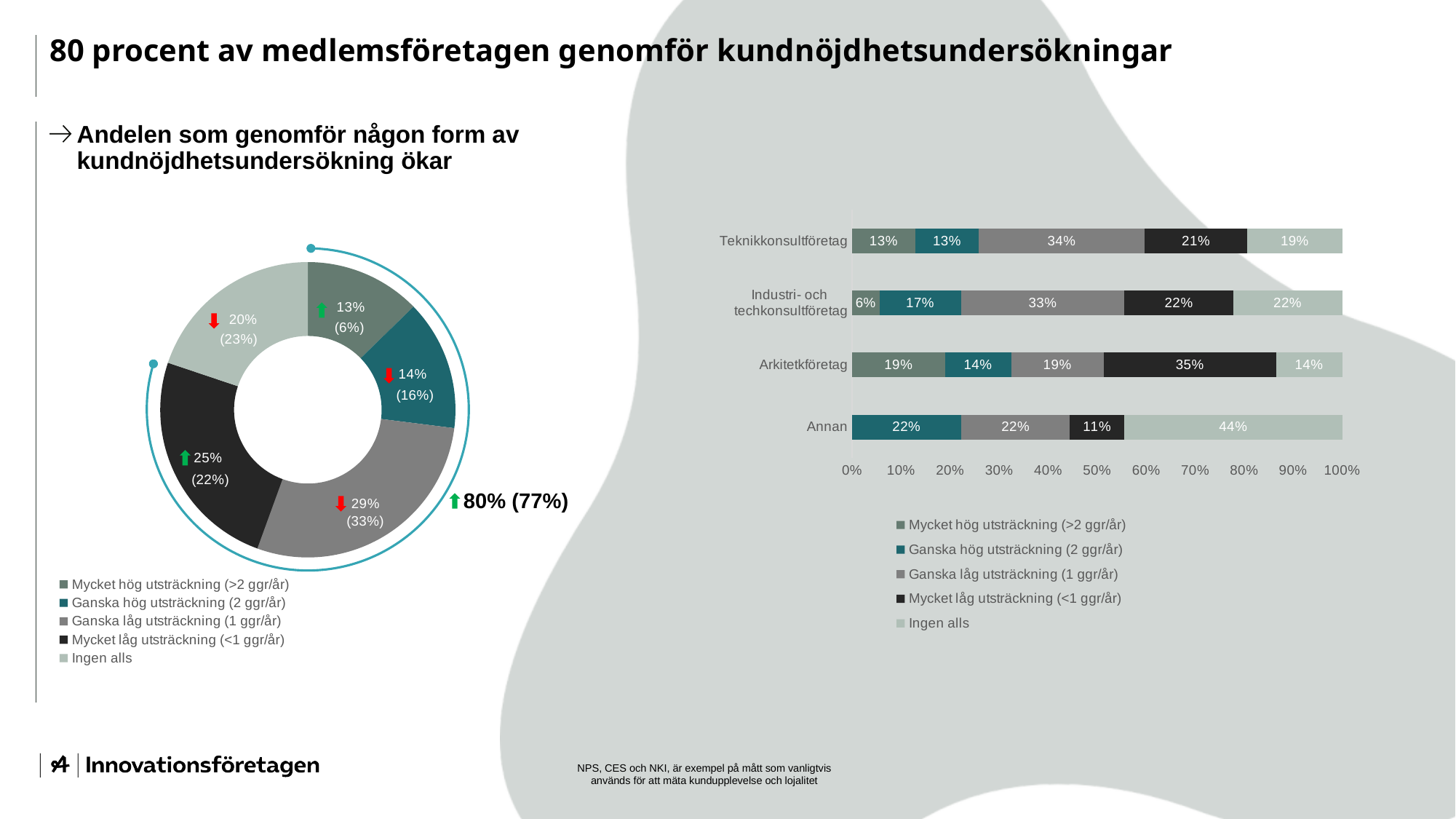
In the stacked bar chart on the right, which category has the lowest value for 'Ingen alls'? Arkitetkföretag In the stacked bar chart on the right, which category has the highest value for 'Mycket låg utsträckning (<1 ggr/år)'? Arkitetkföretag In the stacked bar chart on the right, what is the value for 'Ingen alls' for Annan? 44% In the donut chart on the left, which slice is the largest? Ganska låg utsträckning (1 ggr/år) In the stacked bar chart on the right, what is the value for 'Mycket hög utsträckning (>2 ggr/år)' for Industri- och techkonsultföretag? 6% What kind of chart is the chart on the left of the slide? Donut (pie) chart In the stacked bar chart on the right, is the 'Ganska hög utsträckning (2 ggr/år)' value larger for Industri- och techkonsultföretag or for Arkitektföretag? Industri- och techkonsultföretag How many categories are shown in the stacked bar chart on the right? 4 In the stacked bar chart on the right, what is the difference between the 'Ingen alls' values for Annan and Teknikkonsultföretag? 25% How many series does the legend of the stacked bar chart on the right list? 5 In the donut chart on the left, what is the current share for 'Ganska låg utsträckning (1 ggr/år)'? 29% In the stacked bar chart on the right, what is the value for 'Ganska låg utsträckning (1 ggr/år)' for Teknikkonsultföretag? 34%